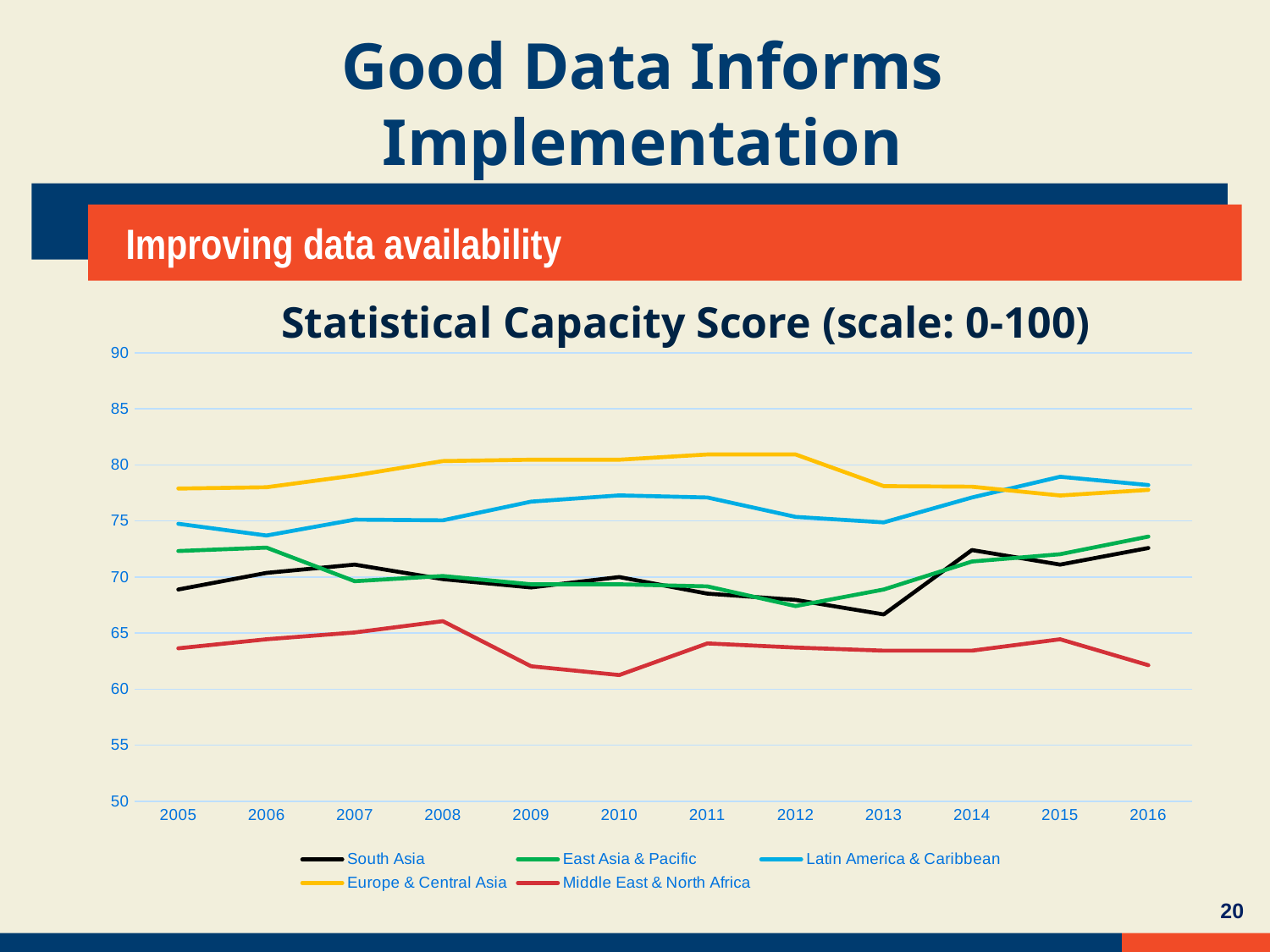
Is the value for Middle East & North Africa in 2010 greater or less than 65? less How many years are shown along the x axis? 12 What colour is the line for Middle East & North Africa? red Is the value for Europe & Central Asia in 2012 greater or less than 80? greater What is the title of the chart? Statistical Capacity Score (scale: 0-100) In 2005, which is higher: Latin America & Caribbean or South Asia? Latin America & Caribbean Does the Middle East & North Africa line rise or fall from 2015 to 2016? fall How many series does the legend list? 5 Is the value for South Asia in 2013 greater or less than 70? less What kind of chart is shown on the slide? line chart Which region has the lowest score in 2016? Middle East & North Africa Which region has the highest score in 2010? Europe & Central Asia